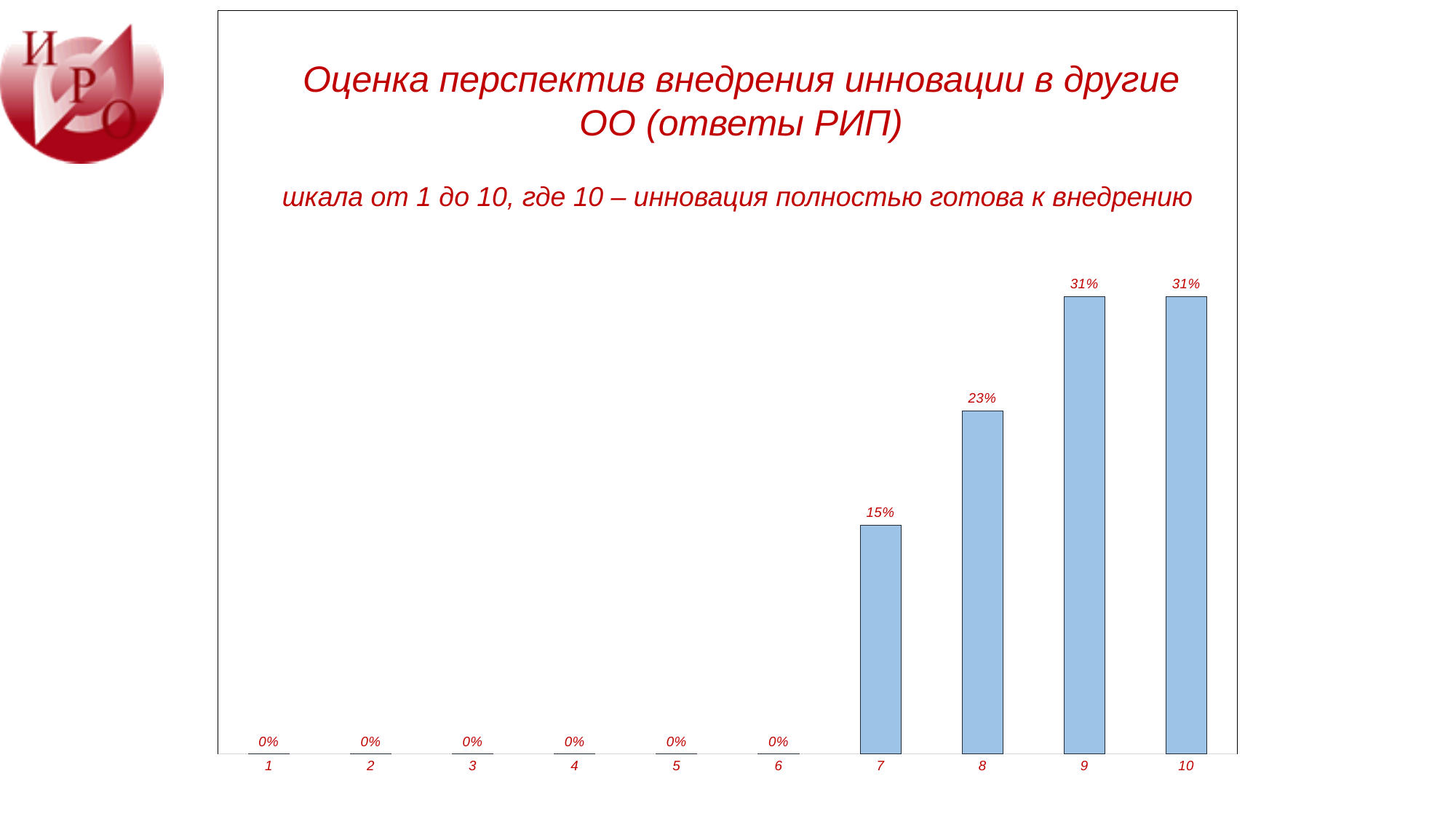
What is the difference between the values for category 9 and category 8? 8% Do the values rise or fall from category 6 to category 9? rise What is the value for category 9? 31% What is the highest value shown in the chart? 31% What kind of chart is shown on the slide? bar chart What is the value for category 3? 0% How many categories have a value of 0%? 6 What is the difference between the values for category 8 and category 7? 8% What is the value for category 7? 15% Which has a larger value, category 7 or category 8? 8 What is the value for category 8? 23% How many categories are shown on the x axis? 10